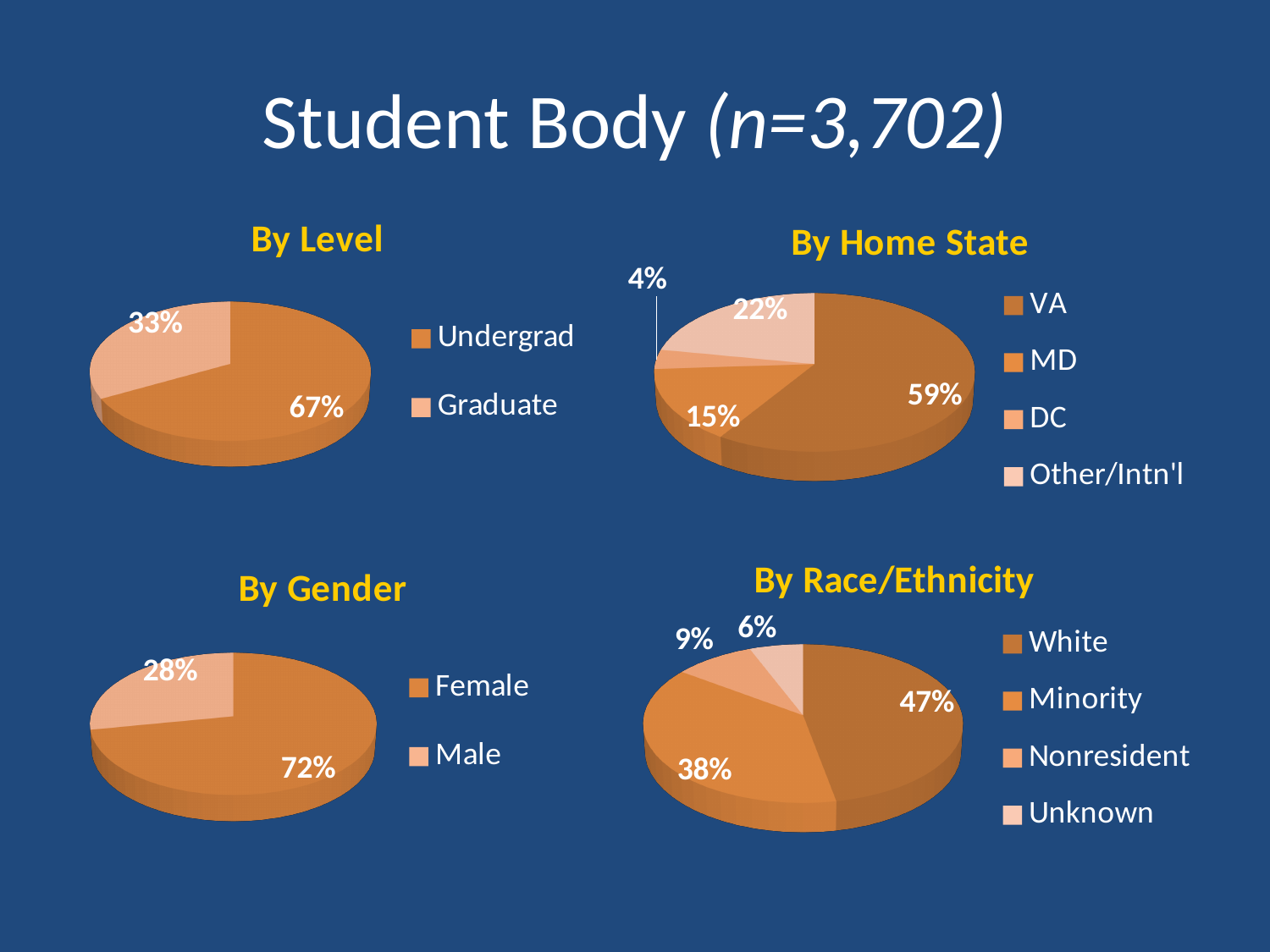
In the By Race/Ethnicity chart, what percentage of students are Minority? 38% In the By Home State chart, what percentage of students are from VA? 59% In the By Gender chart, which is larger, the Female share or the Male share? Female What type of chart is used for the By Gender breakdown? Pie chart In the By Gender chart, what percentage of students are Female? 72% In the By Home State chart, what percentage of students are from DC? 4% In the By Race/Ethnicity chart, which category has the largest share? White In the By Level chart, what share of the pie does Graduate represent? 33% How many categories does the legend of the By Race/Ethnicity chart list? 4 In the By Home State chart, which home state category has the smallest share? DC In the By Home State chart, what is the difference between the MD share and the Other/Intn'l share? 7% In the By Level chart, what percentage of the student body is Undergrad? 67%